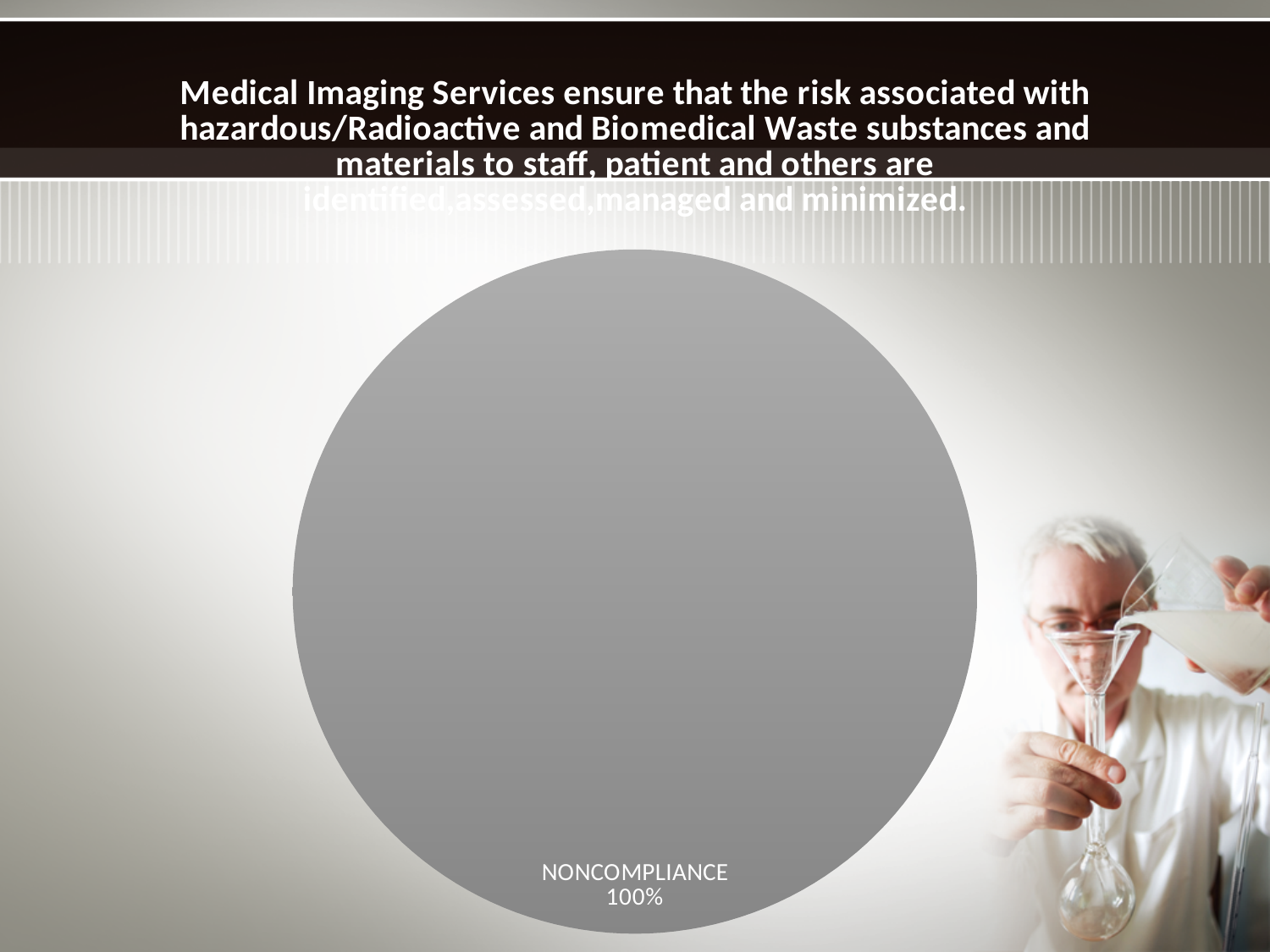
What share of the pie does NONCOMPLIANCE account for? 100% What is the label of the only slice in the pie chart? NONCOMPLIANCE What kind of chart is shown on the slide? pie chart Is the value for NONCOMPLIANCE greater or less than 50%? greater What is the value printed for the NONCOMPLIANCE slice? 100% How many slices does the pie chart have? 1 Which category is the largest slice of the pie chart? NONCOMPLIANCE